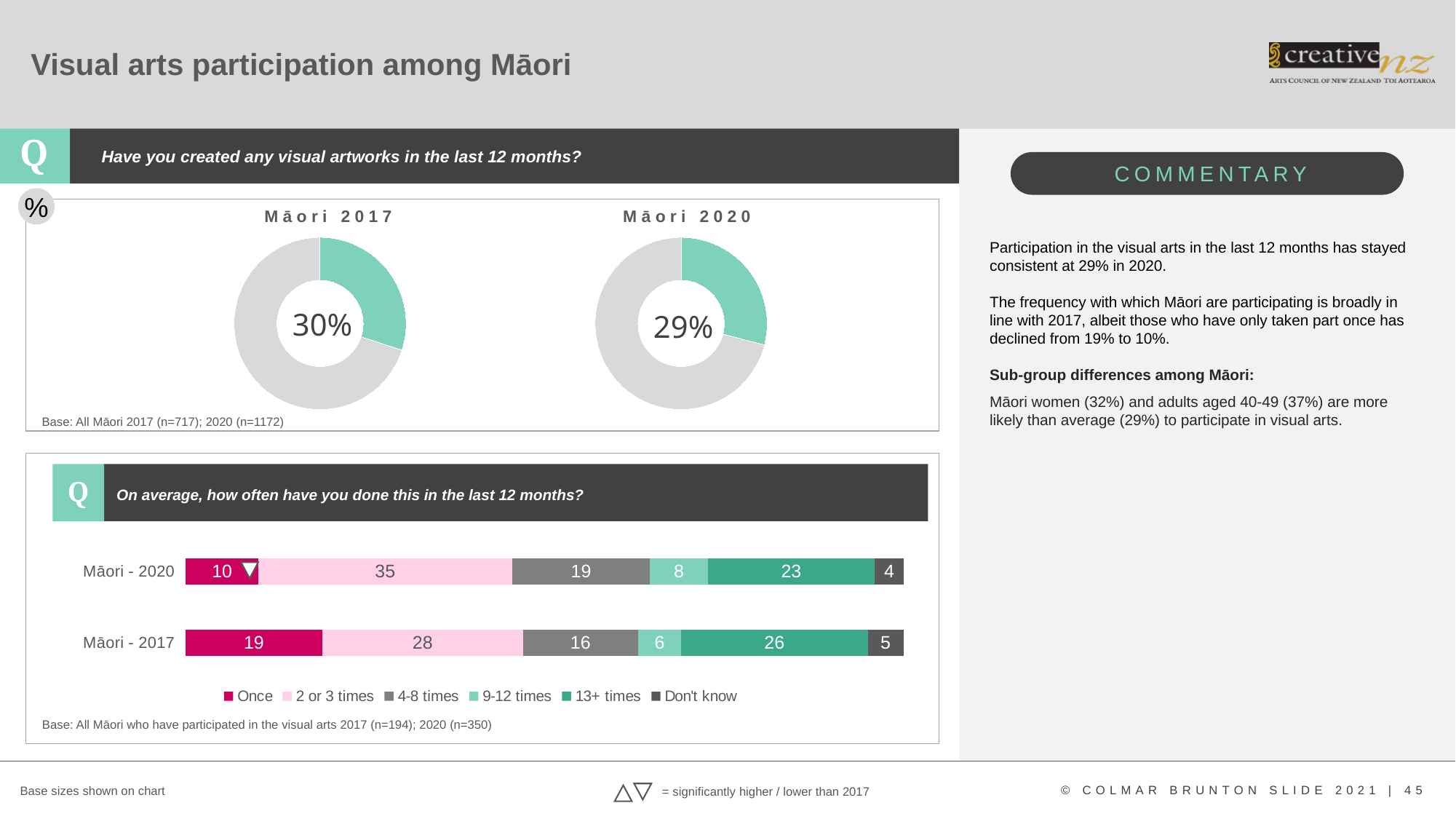
In the donut charts at the top, which year shows the higher participation percentage, Māori 2017 or Māori 2020? Māori 2017 In the stacked bar chart at the bottom, how many bars are shown? 2 In the donut charts at the top, what percentage is shown for Māori 2020? 29% In the stacked bar chart at the bottom, which segment is the smallest for Māori - 2017? Don't know In the stacked bar chart at the bottom, what is the difference between the 'Once' values for Māori - 2017 and Māori - 2020? 9 In the donut charts at the top, what percentage is shown for Māori 2017? 30% In the stacked bar chart at the bottom, what is the value for '13+ times' for Māori - 2020? 23 In the stacked bar chart at the bottom, how many series does the legend list? 6 In the stacked bar chart at the bottom, what is the value for 'Once' for Māori - 2020? 10 In the stacked bar chart at the bottom, what is the value for '2 or 3 times' for Māori - 2017? 28 What type of chart is used for the 'On average, how often have you done this in the last 12 months?' question? Stacked bar chart In the stacked bar chart at the bottom, which segment is the largest for Māori - 2020? 2 or 3 times